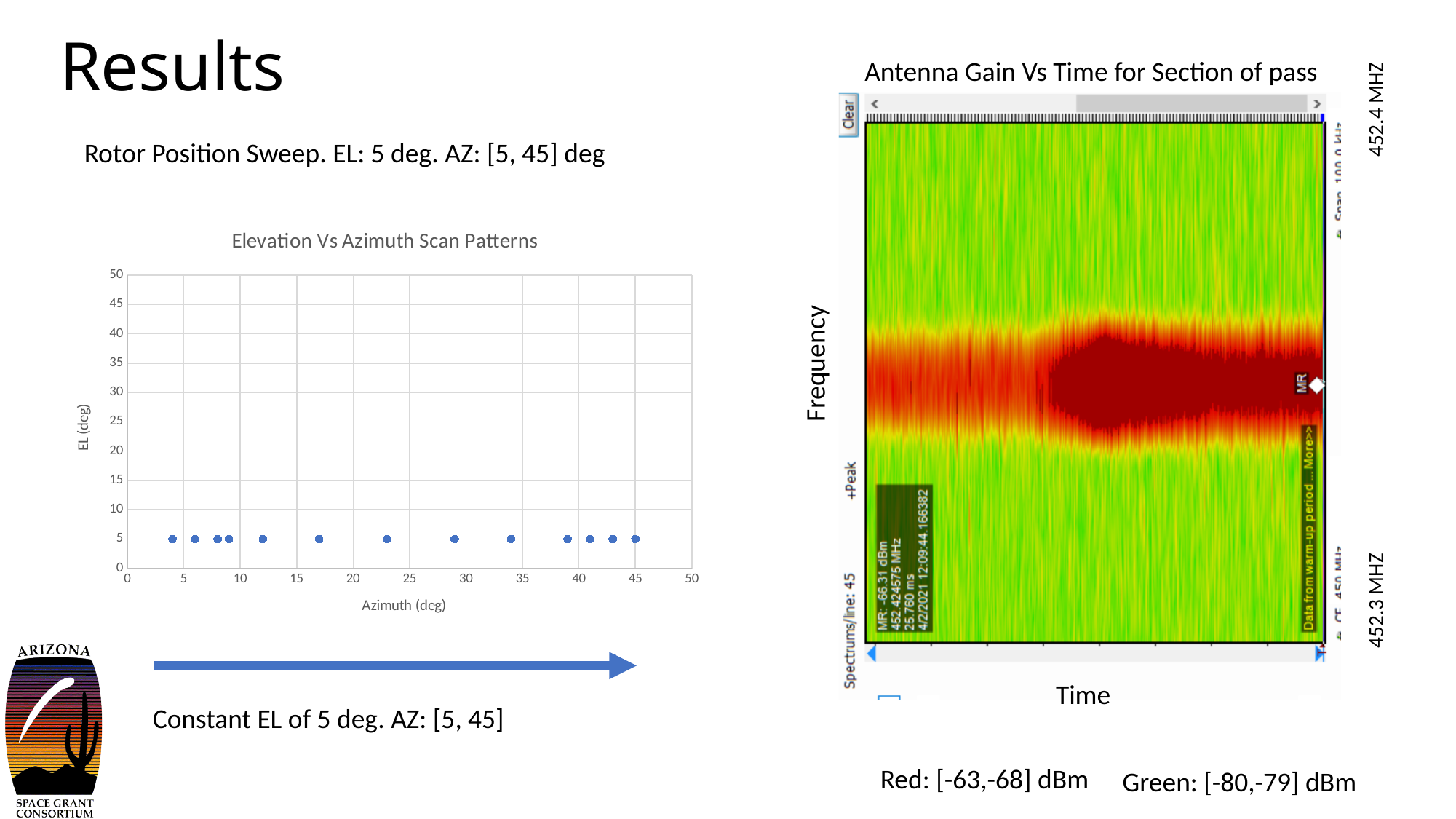
What is the maximum value shown on the y axis of the 'Elevation Vs Azimuth Scan Patterns' chart? 50 In the 'Elevation Vs Azimuth Scan Patterns' chart, is the azimuth of the rightmost point greater or less than 40? greater What is the vertical axis label of the 'Antenna Gain Vs Time for Section of pass' chart? Frequency In the 'Elevation Vs Azimuth Scan Patterns' chart, do the EL values rise, fall, or stay constant as azimuth increases? Stay constant What is the x-axis label of the 'Elevation Vs Azimuth Scan Patterns' chart? Azimuth (deg) What type of chart is the 'Elevation Vs Azimuth Scan Patterns' chart? Scatter chart In the 'Elevation Vs Azimuth Scan Patterns' chart, what is the EL (deg) value of the point at azimuth 45 deg? 5 In the 'Elevation Vs Azimuth Scan Patterns' chart, is the azimuth of the leftmost point greater or less than 10? less In the 'Elevation Vs Azimuth Scan Patterns' chart, what EL (deg) value do all the plotted points share? 5 In the 'Elevation Vs Azimuth Scan Patterns' chart, is the EL value of the point at azimuth 45 greater or less than 10? less